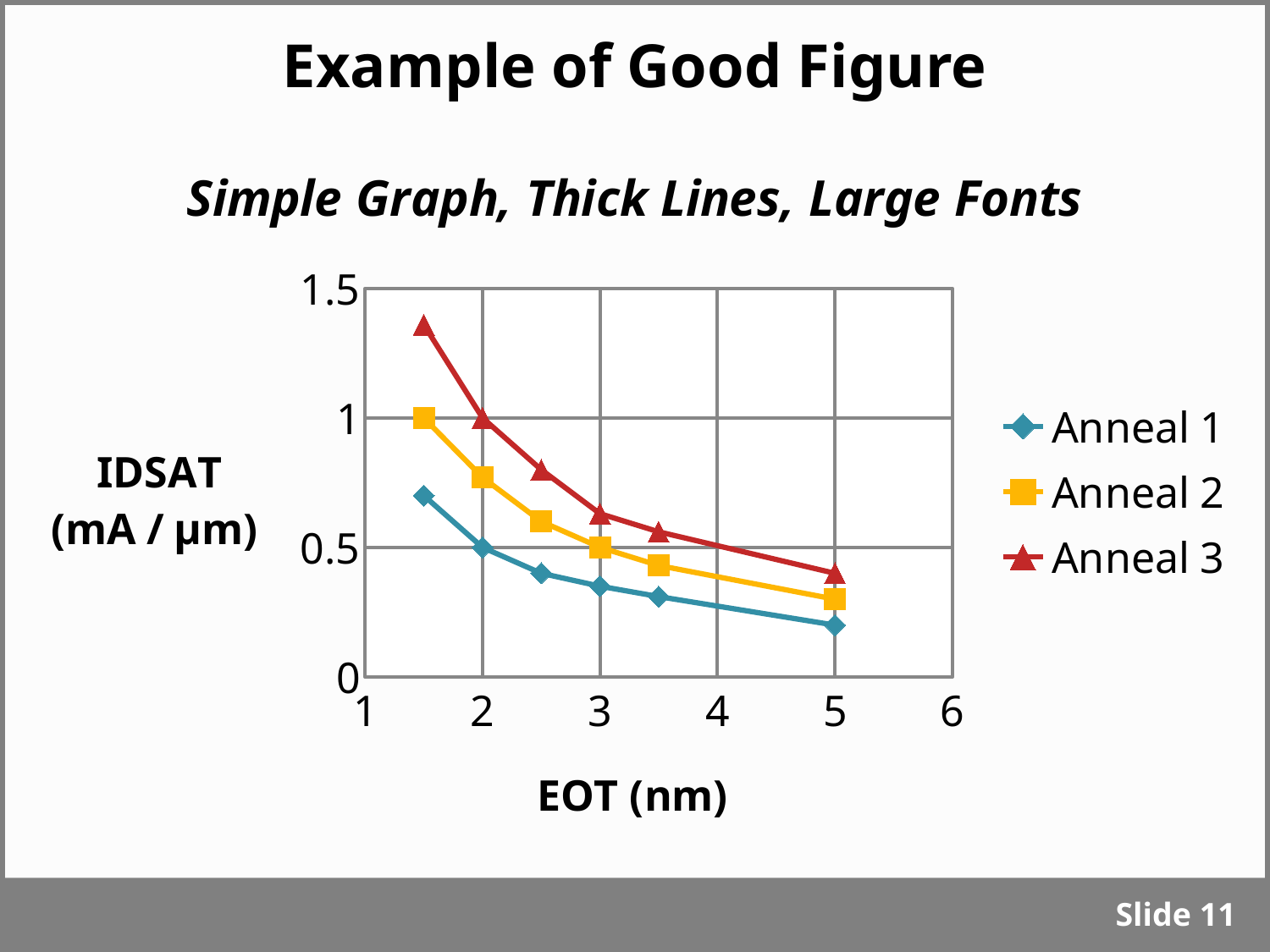
Which series has the highest IDSAT value at EOT 1.5 nm? Anneal 3 Is the value for Anneal 3 at EOT 1.5 nm greater or less than 1? greater How many data points are plotted for the Anneal 1 series? 6 How many series does the legend list? 3 What is the label on the y axis of the chart? IDSAT (mA / µm) At EOT 3 nm, which is larger: the value for Anneal 3 or the value for Anneal 1? Anneal 3 Do the IDSAT values rise or fall as EOT increases? fall Is the value for Anneal 1 at EOT 1.5 nm greater or less than 0.5? greater What is the label on the x axis of the chart? EOT (nm) Is the value for Anneal 1 at EOT 5 nm greater or less than 0.5? less What kind of chart is shown on the slide? line chart Which series has the lowest IDSAT value at EOT 5 nm? Anneal 1